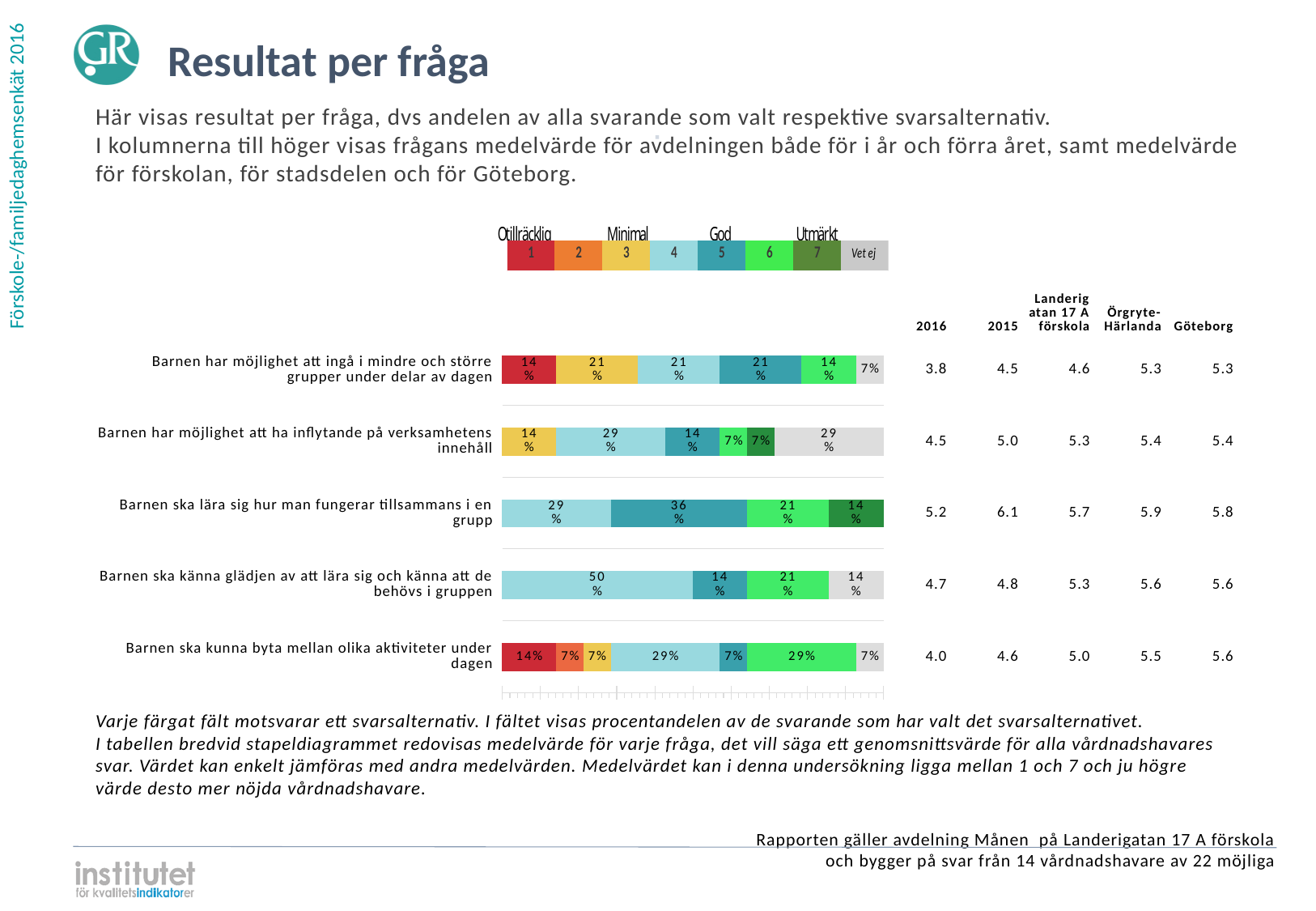
What is the Göteborg mean value for 'Barnen ska kunna byta mellan olika aktiviteter under dagen'? 5.6 What percentage chose answer 5 (teal) for 'Barnen ska lära sig hur man fungerar tillsammans i en grupp'? 36% How many questions (bars) are shown in the chart? 5 What percentage chose 'Vet ej' for 'Barnen har möjlighet att ha inflytande på verksamhetens innehåll'? 29% How many response categories does the legend above the chart list? 8 For 'Barnen ska kunna byta mellan olika aktiviteter under dagen', which is larger: the share choosing answer 4 (light blue) or answer 1 (red)? Answer 4 (light blue) Which question has the lowest 2016 mean value in the table? Barnen har möjlighet att ingå i mindre och större grupper under delar av dagen What kind of chart is used to show the distribution of answers per question? Stacked bar chart What is the largest single segment in the bar for 'Barnen ska känna glädjen av att lära sig och känna att de behövs i gruppen'? 50% What percentage of respondents chose answer 1 (red) for 'Barnen har möjlighet att ingå i mindre och större grupper under delar av dagen'? 14% Which question has the highest 2016 mean value in the table? Barnen ska lära sig hur man fungerar tillsammans i en grupp What is the difference between the 2015 and 2016 mean for 'Barnen ska lära sig hur man fungerar tillsammans i en grupp'? 0.9